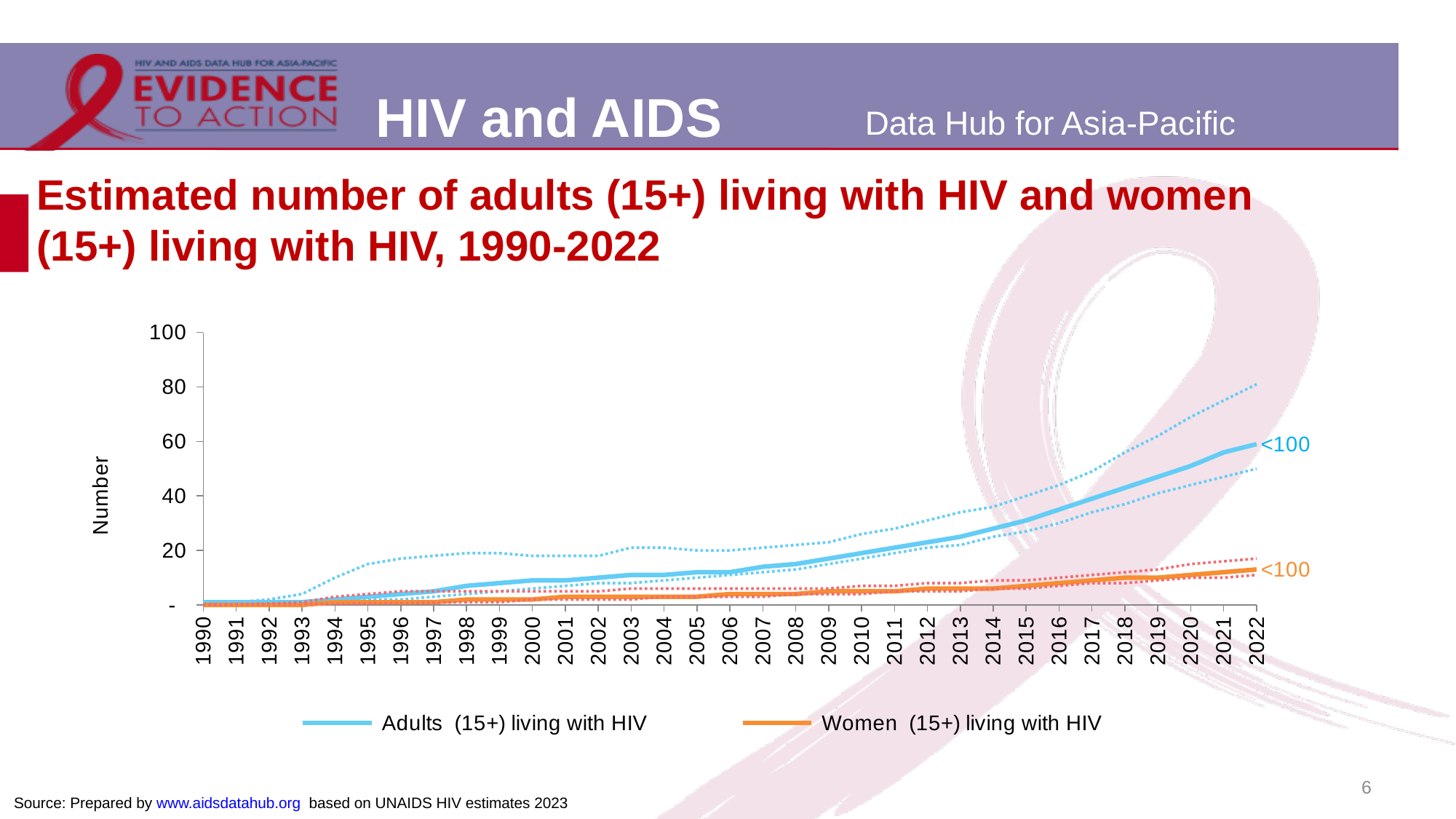
How many series does the legend list? 2 Is the value for Adults (15+) living with HIV in 2005 greater or less than 20? less What data label is shown at the end of the Adults (15+) living with HIV line in 2022? <100 How many years are plotted along the x axis? 33 In 2022, which series has the larger value: Adults (15+) living with HIV or Women (15+) living with HIV? Adults (15+) living with HIV Does the Adults (15+) living with HIV line rise or fall from 1990 to 2022? Rise Is the value for Adults (15+) living with HIV in 2022 greater or less than 40? greater What data label is shown at the end of the Women (15+) living with HIV line in 2022? <100 What colour is the line for Women (15+) living with HIV? Orange Is the value for Women (15+) living with HIV in 2022 greater or less than 20? less What kind of chart is shown on the slide? Line chart